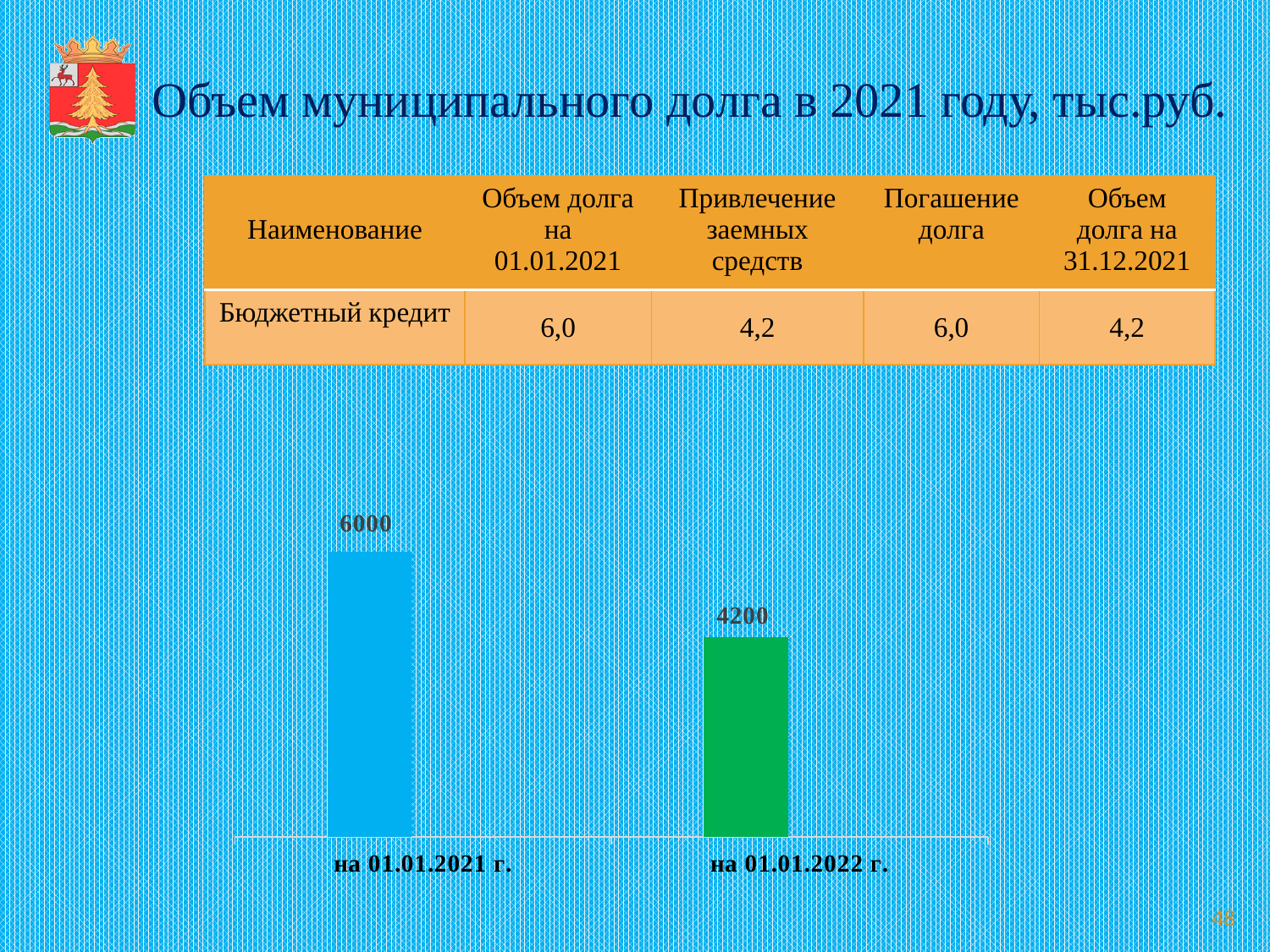
What is the value for "на 01.01.2022 г."? 4200 What is the difference between the value for "на 01.01.2021 г." and the value for "на 01.01.2022 г."? 1800 What colour is the bar for "на 01.01.2022 г."? green Which is larger: the value for "на 01.01.2021 г." or the value for "на 01.01.2022 г."? на 01.01.2021 г. What colour is the bar for "на 01.01.2021 г."? blue Which category has the highest value? на 01.01.2021 г. What kind of chart is shown on the slide? bar chart How many categories are shown in the chart? 2 Which category has the lowest value? на 01.01.2022 г. What is the value for "на 01.01.2021 г."? 6000 Do the values rise or fall from "на 01.01.2021 г." to "на 01.01.2022 г."? fall